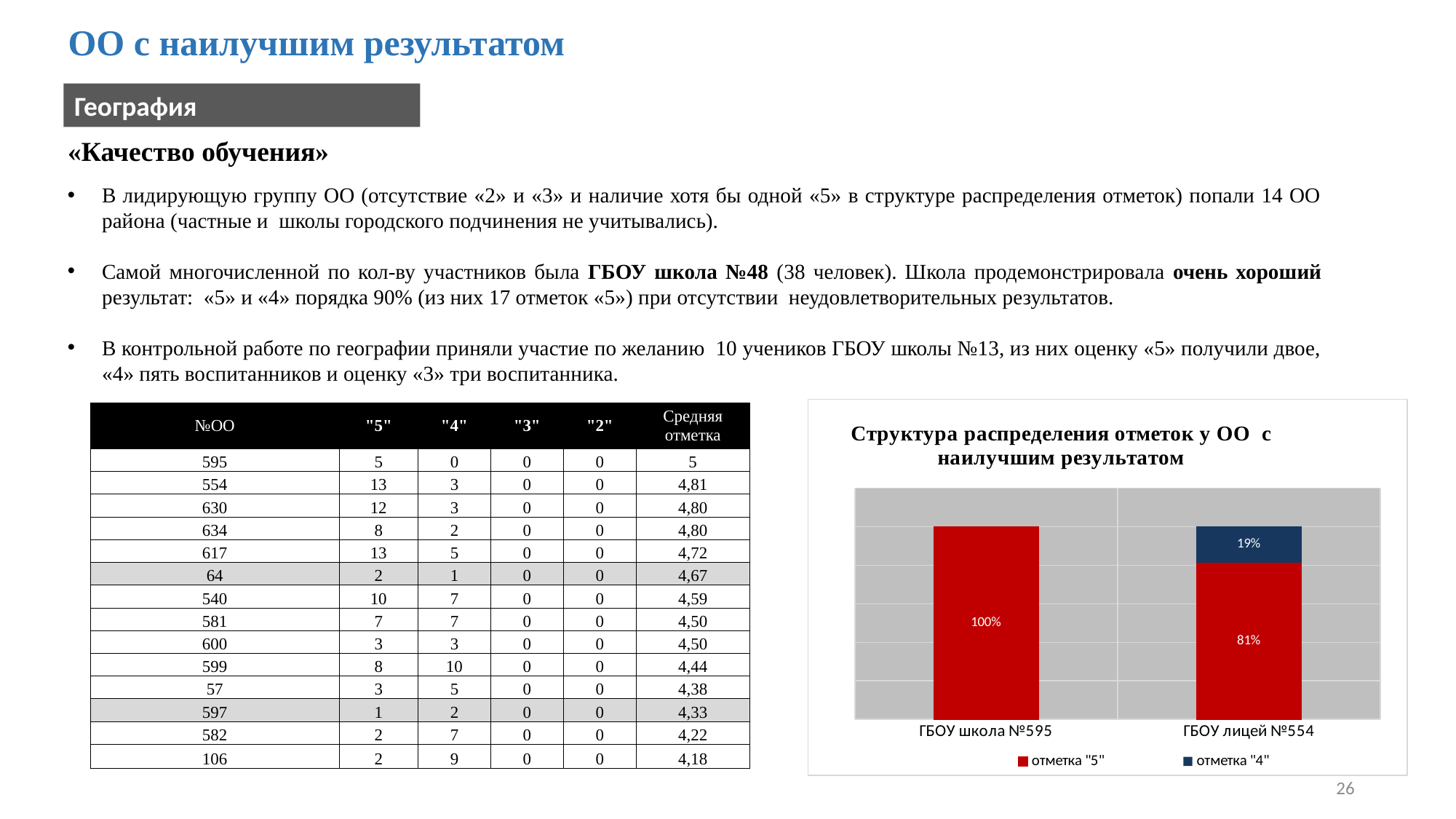
At ГБОУ лицей №554, which is larger: the share of отметка "5" or the share of отметка "4"? отметка "5" How many series does the chart legend list? 2 What are the two series listed in the chart legend? отметка "5" and отметка "4" What share of marks at ГБОУ лицей №554 are отметка "4"? 19% What share of marks at ГБОУ школа №595 are отметка "5"? 100% What share of marks at ГБОУ лицей №554 are отметка "5"? 81% What kind of chart is shown on the slide? Stacked bar chart How many categories (schools) are shown on the x axis of the chart? 2 What is the difference between the share of отметка "5" at ГБОУ школа №595 and at ГБОУ лицей №554? 19% What is the title of the chart on the slide? Структура распределения отметок у ОО с наилучшим результатом Which school has the lower share of отметка "5"? ГБОУ лицей №554 Which school has the higher share of отметка "5"? ГБОУ школа №595